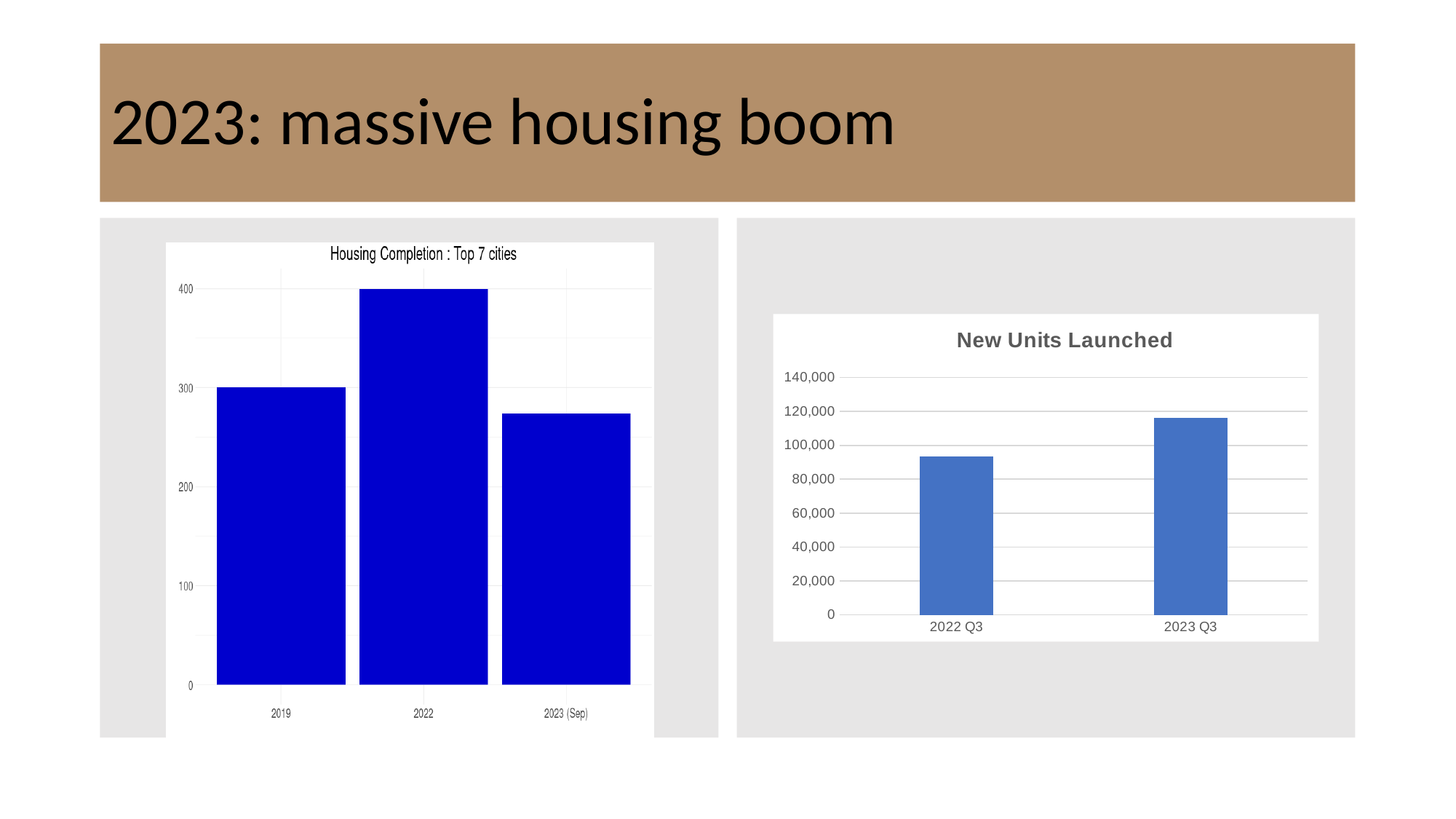
In the 'New Units Launched' chart, is the value for 2023 Q3 greater or less than 120,000? less What kind of chart is the 'New Units Launched' chart? bar chart In the 'Housing Completion : Top 7 cities' chart, what is the difference between the values for 2022 and 2019? 100 In the 'Housing Completion : Top 7 cities' chart, which year has the highest value? 2022 In the 'Housing Completion : Top 7 cities' chart, what is the value for 2022? 400 In the 'New Units Launched' chart, which quarter has the higher value, 2022 Q3 or 2023 Q3? 2023 Q3 In the 'Housing Completion : Top 7 cities' chart, what is the value for 2019? 300 In the 'Housing Completion : Top 7 cities' chart, how many bars are plotted? 3 In the 'New Units Launched' chart, how many categories are shown on the x axis? 2 In the 'Housing Completion : Top 7 cities' chart, which category has the lowest value? 2023 (Sep) In the 'Housing Completion : Top 7 cities' chart, is the value for 2023 (Sep) greater or less than 300? less In the 'New Units Launched' chart, is the value for 2022 Q3 greater or less than 80,000? greater